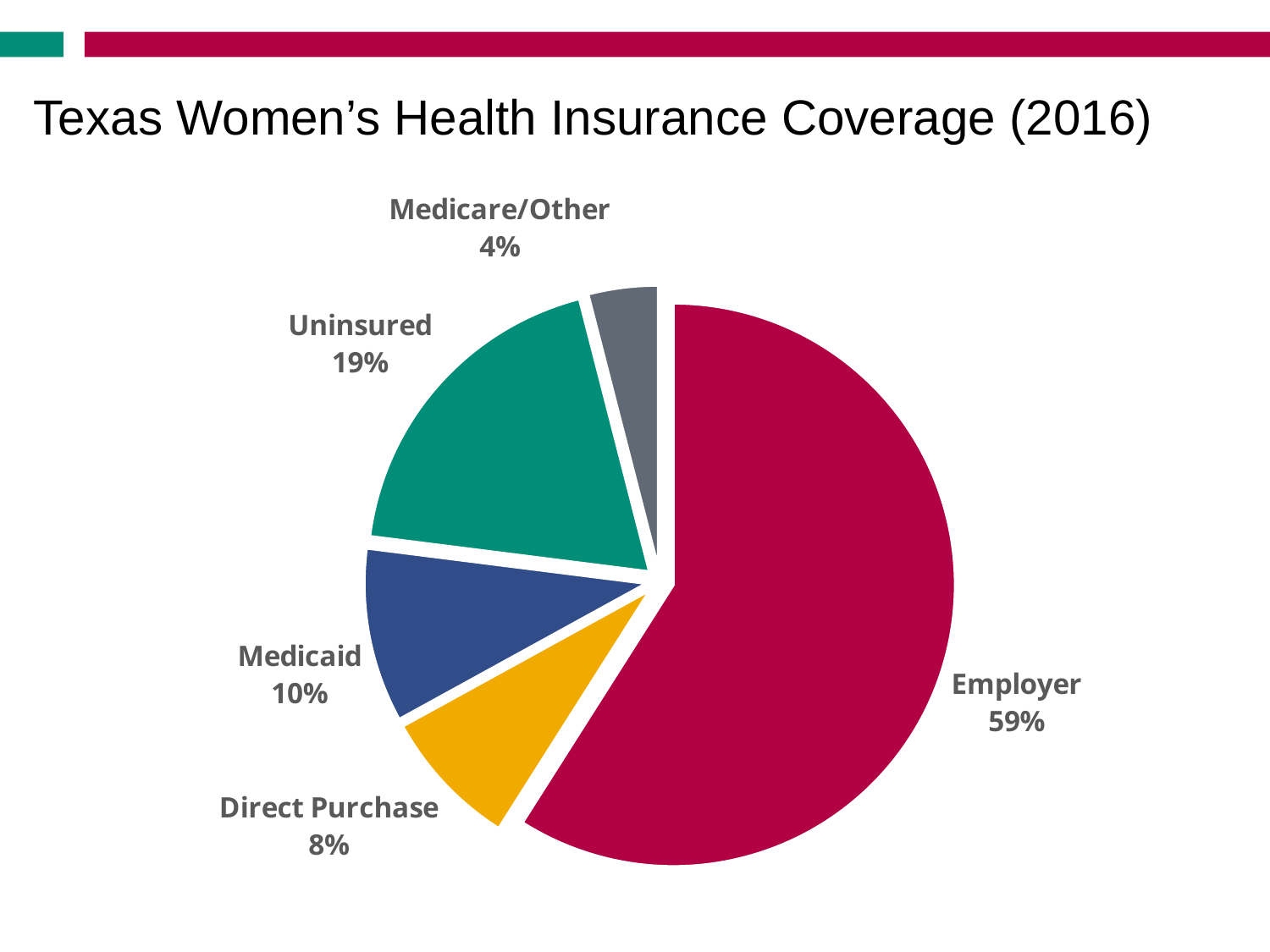
Which category has the smallest slice of the pie? Medicare/Other How many slices does the pie chart have? 5 What is the value shown for Medicare/Other? 4% Which category has the largest slice of the pie? Employer What kind of chart is shown on the slide? pie chart What is the value shown for Medicaid? 10% What is the difference in percentage points between Employer and Uninsured? 40 What is the value shown for Direct Purchase? 8% What share of Texas women's health insurance coverage is Employer? 59% Which is larger, Medicaid or Direct Purchase? Medicaid What is the title of the slide containing the chart? Texas Women's Health Insurance Coverage (2016) What percentage of the pie is Uninsured? 19%